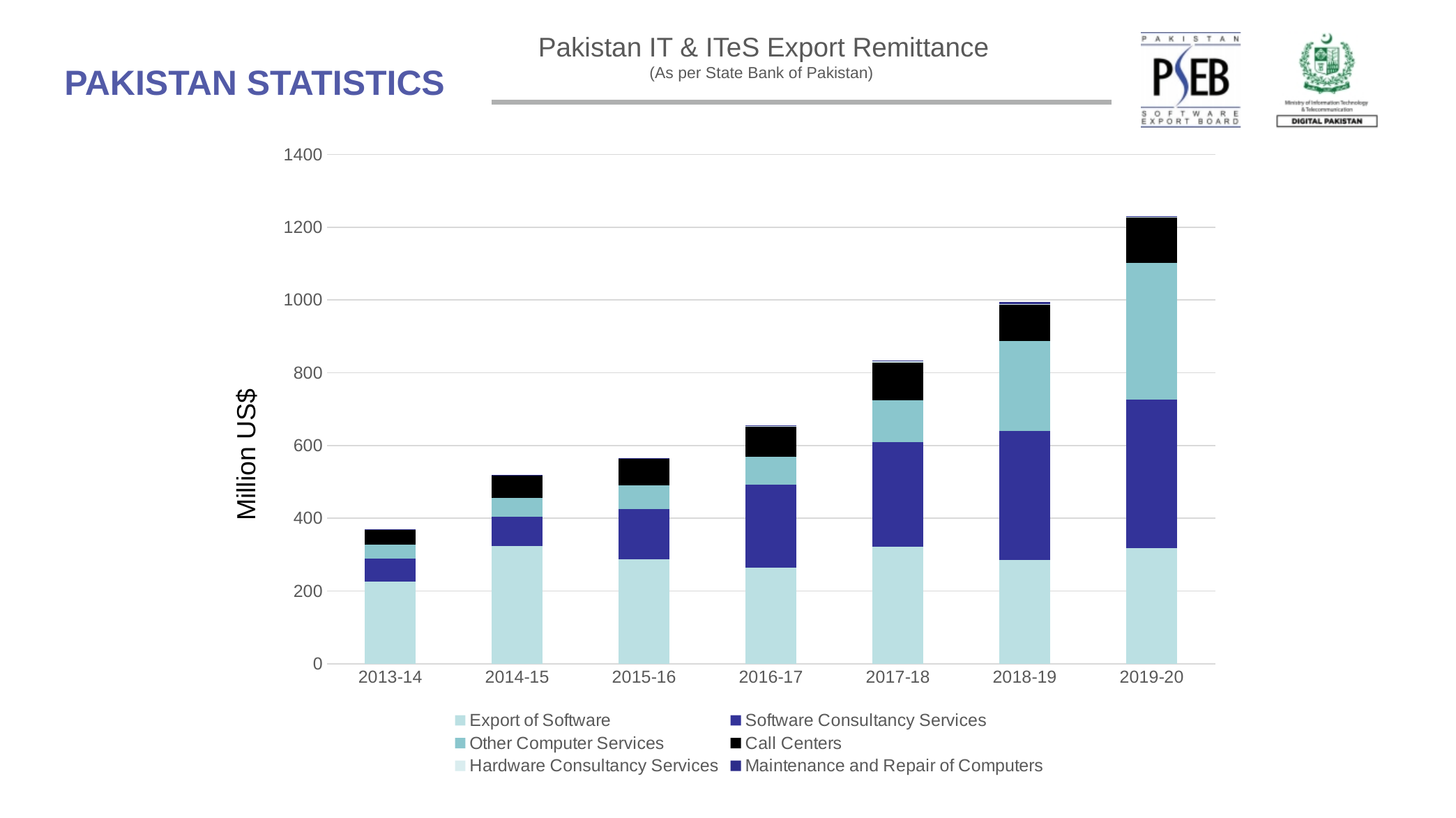
What is the label on the y axis of the chart? Million US$ Which year has a larger total export remittance, 2018-19 or 2019-20? 2019-20 How many series does the chart's legend list? 6 Is the total value for 2019-20 greater or less than 1000? greater Which year has the highest total IT & ITeS export remittance? 2019-20 Is the total value for 2016-17 greater or less than 600? greater How many fiscal years are shown on the x axis of the chart? 7 Which year has the lowest total IT & ITeS export remittance? 2013-14 Which colour represents Call Centers in the chart's legend? Black What kind of chart is shown on the slide? Stacked bar chart Do the total export remittances rise or fall from 2013-14 to 2019-20? Rise Is the total value for 2013-14 greater or less than 400? less